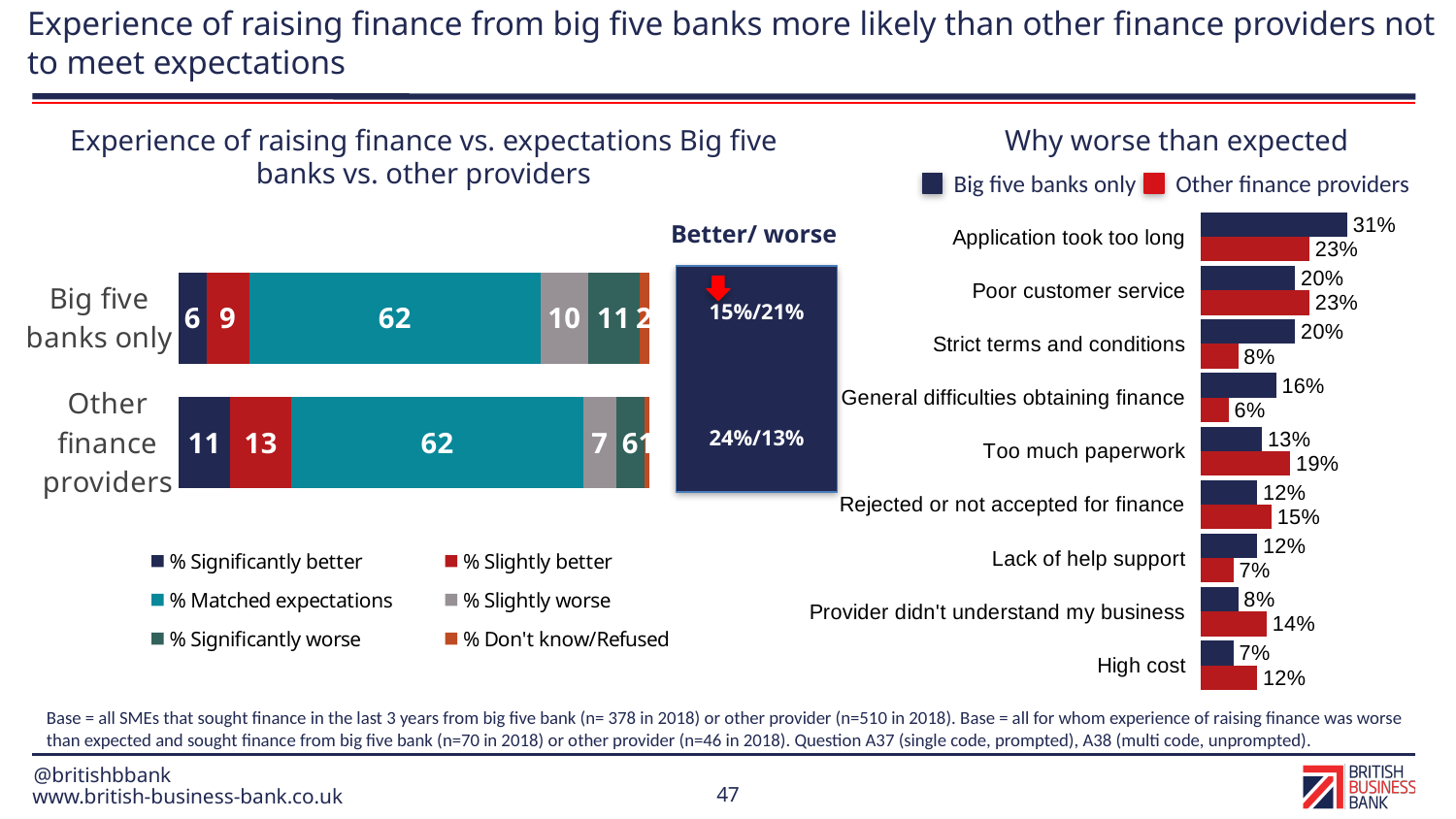
In the 'Why worse than expected' chart, what is the value for Big five banks only for 'Application took too long'? 31% In the 'Why worse than expected' chart, which reason has the highest value for Big five banks only? Application took too long What kind of chart is the 'Experience of raising finance vs. expectations' chart? Stacked bar chart In the 'Why worse than expected' chart, which is larger for 'High cost': Big five banks only or Other finance providers? Other finance providers In the 'Experience of raising finance vs. expectations' chart, what is the '% Matched expectations' value for Big five banks only? 62 In the 'Why worse than expected' chart, which reason has the lowest value for Other finance providers? General difficulties obtaining finance How many series does the legend of the 'Why worse than expected' chart list? 2 In the 'Why worse than expected' chart, what is the value for Other finance providers for 'Too much paperwork'? 19% In the 'Experience of raising finance vs. expectations' chart, what is the '% Significantly better' value for Other finance providers? 11 In the 'Why worse than expected' chart, what is the difference between Big five banks only and Other finance providers for 'Strict terms and conditions'? 12% How many reasons are listed in the 'Why worse than expected' chart? 9 How many series does the legend of the 'Experience of raising finance vs. expectations' chart list? 6